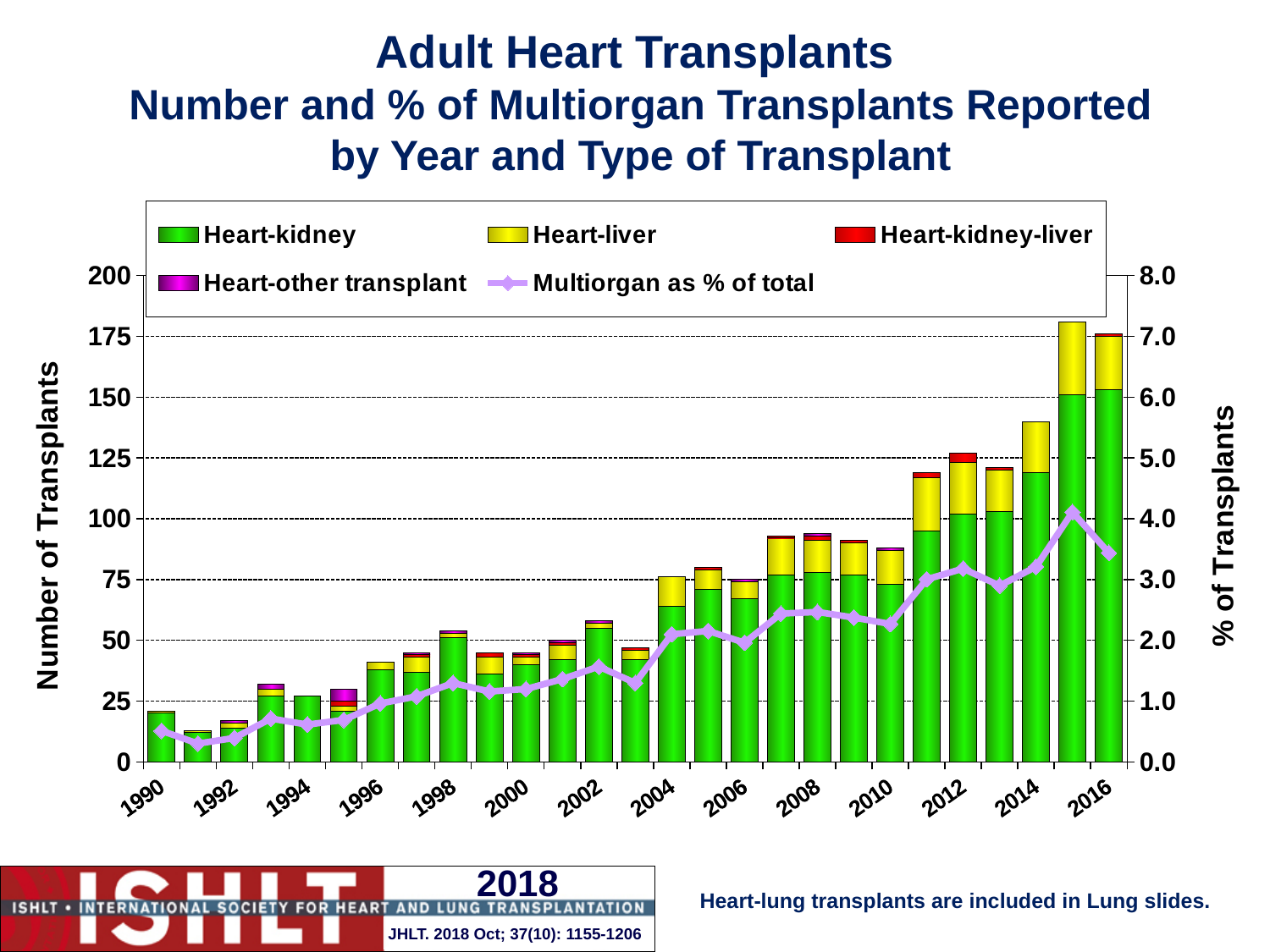
Is the Multiorgan as % of total value for 1991 greater or less than 1.0? less Which year has the larger total number of transplants, 2013 or 2014? 2014 How many series does the legend list? 5 Is the total number of transplants for 2014 greater or less than 125? greater Which year has the shortest stacked bar for number of multiorgan transplants? 1991 Is the Multiorgan as % of total value for 2016 greater or less than 3.0? greater Overall, does the number of multiorgan transplants rise or fall from 1990 to 2016? rise How many years (bars) are plotted along the x axis? 27 Which year has the tallest stacked bar for number of multiorgan transplants? 2015 What kind of chart is shown on the slide? bar chart (stacked, with a line)